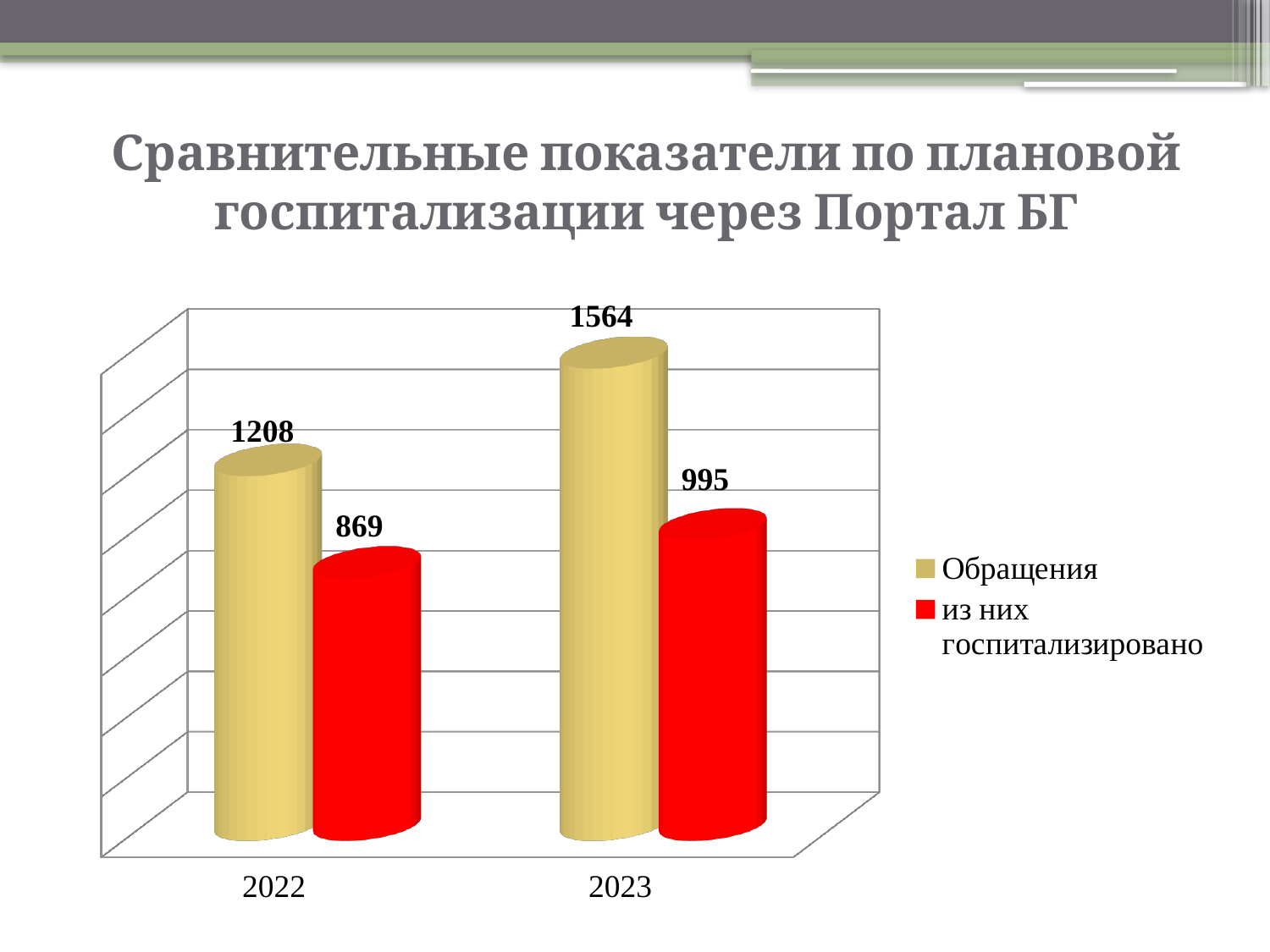
What is the value of из них госпитализировано for 2022? 869 Which year has the highest value for Обращения? 2023 How many series does the legend list? 2 What is the difference between Обращения in 2023 and Обращения in 2022? 356 Which is larger: из них госпитализировано in 2023 or Обращения in 2022? Обращения in 2022 What is the difference between Обращения and из них госпитализировано in 2022? 339 What is the value of Обращения for 2023? 1564 What is the value of из них госпитализировано for 2023? 995 What is the value of Обращения for 2022? 1208 What kind of chart is shown on the slide? Bar chart Which year has the lowest value for из них госпитализировано? 2022 How many years are shown on the x axis? 2